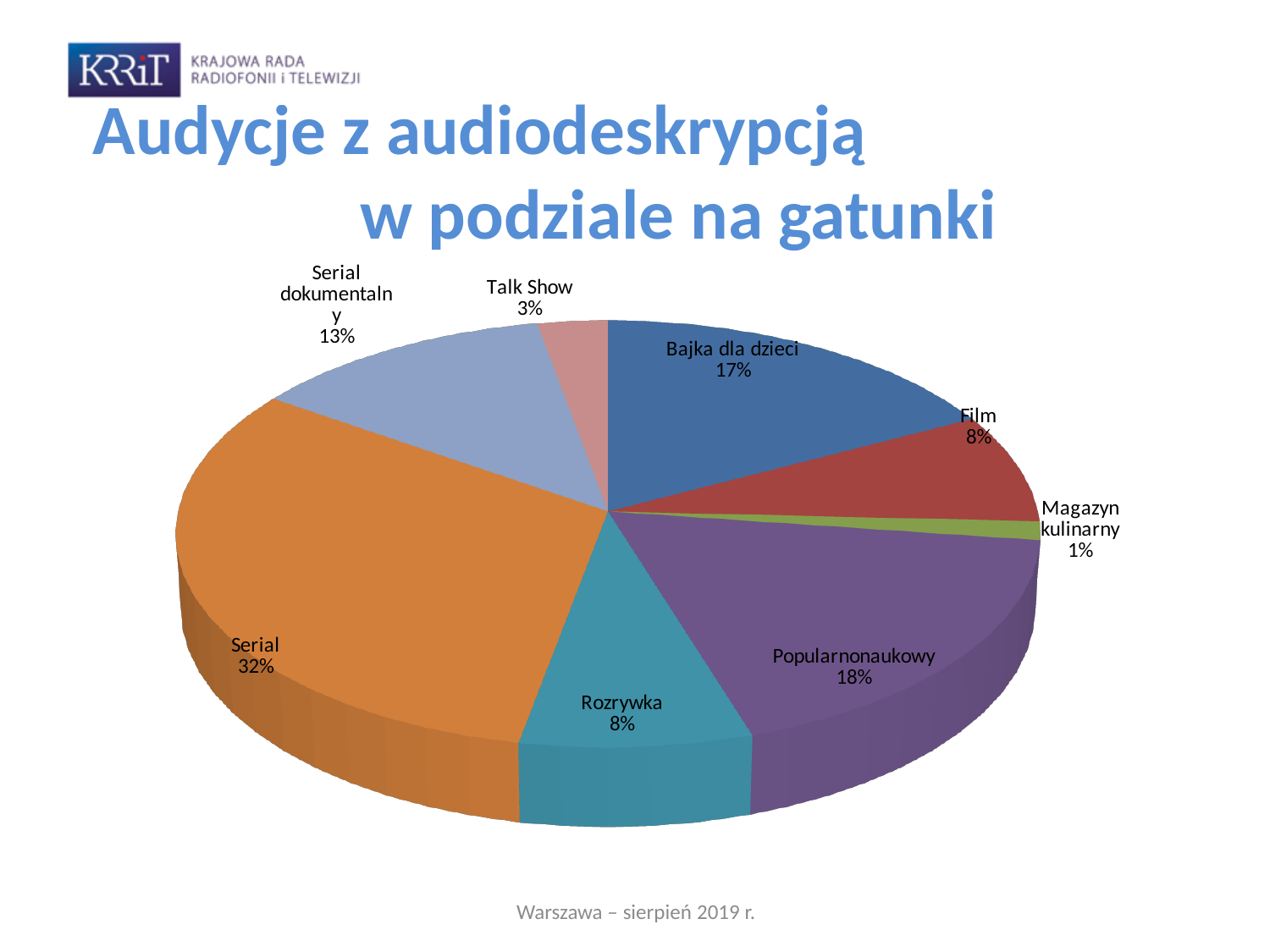
What percentage is shown for Talk Show? 3% What is the value shown for Bajka dla dzieci? 17% Which category has the smallest slice of the pie? Magazyn kulinarny What kind of chart is shown on the slide? Pie chart What is the difference between the shares of Serial and Popularnonaukowy? 14% Which category has the largest slice of the pie? Serial What is the value for Serial dokumentalny? 13% What is the title of the chart on the slide? Audycje z audiodeskrypcją w podziale na gatunki How many categories are shown in the pie chart? 8 What share of the pie does Serial have? 32% Which is larger, the share for Bajka dla dzieci or the share for Serial dokumentalny? Bajka dla dzieci What percentage is shown for Popularnonaukowy? 18%